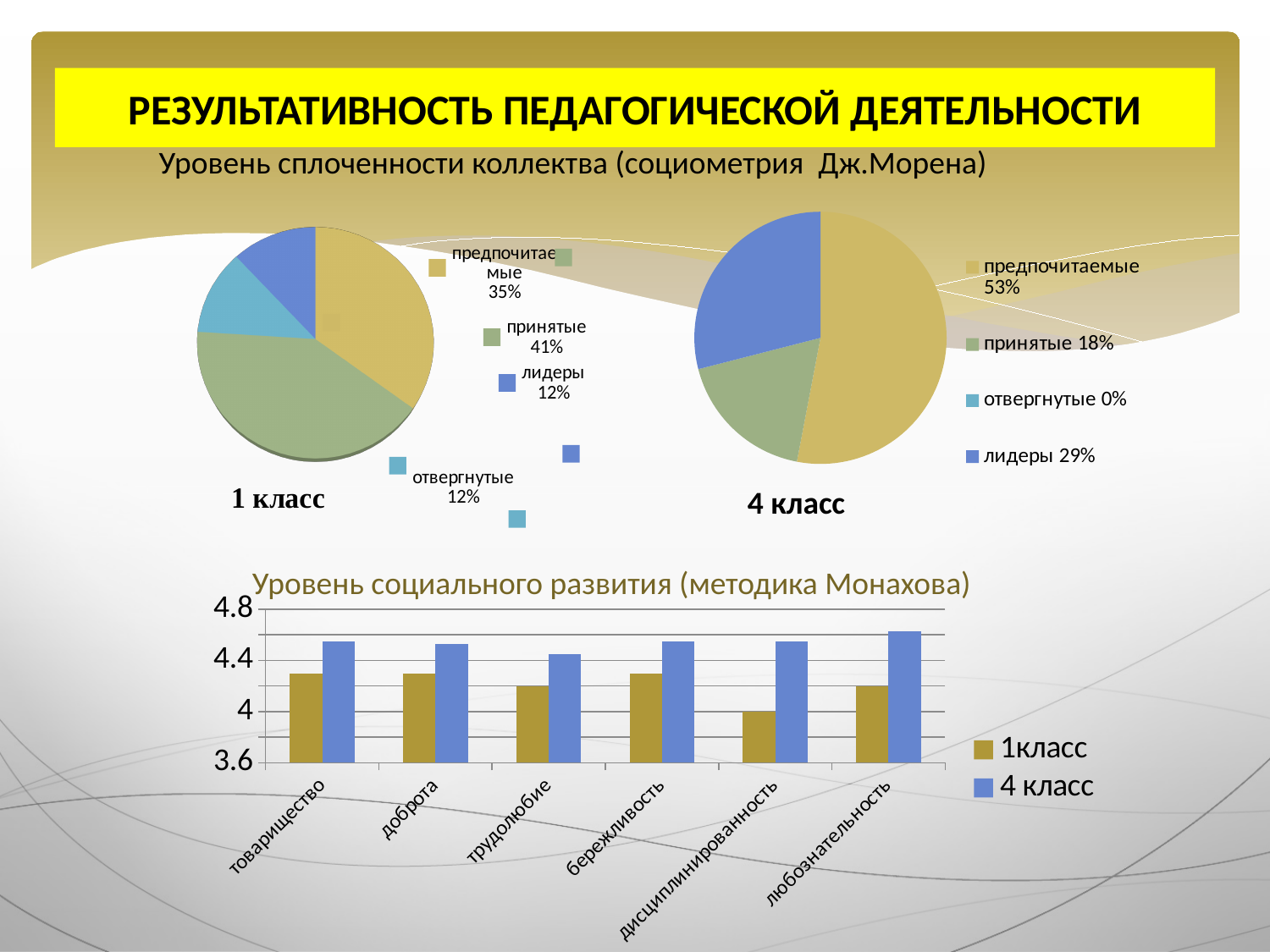
In the pie chart for 4 класс, what share is отвергнутые? 0% In the chart 'Уровень социального развития (методика Монахова)', is the value for 4 класс at любознательность greater or less than 4.4? greater What is the difference between the предпочитаемые share in 4 класс and in 1 класс? 18% In the pie chart for 1 класс, which category has the largest share? принятые In the pie chart for 1 класс, what share is предпочитаемые? 35% In the pie chart for 1 класс, what share is принятые? 41% How many categories does the legend of the 4 класс pie chart list? 4 How many series does the legend of the chart 'Уровень социального развития (методика Монахова)' list? 2 What kind of chart is 'Уровень социального развития (методика Монахова)'? bar chart In the chart 'Уровень социального развития (методика Монахова)', which category has the lowest value for 1класс? дисциплинированность In the pie chart for 4 класс, which category has the largest share? предпочитаемые In the pie chart for 4 класс, what share is лидеры? 29%